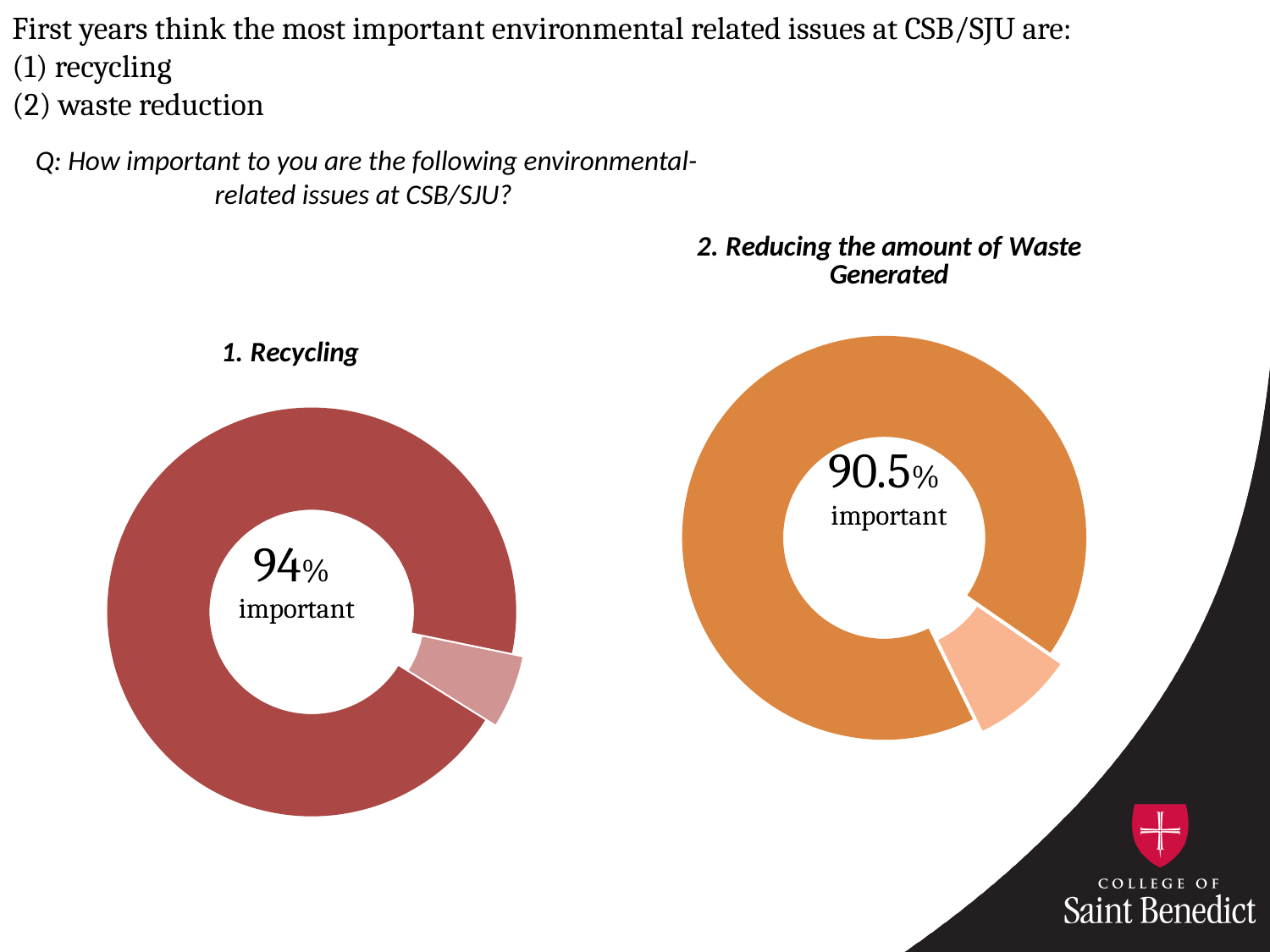
Is the 'important' value in the '2. Reducing the amount of Waste Generated' chart greater or less than 95%? less In the '2. Reducing the amount of Waste Generated' chart, what percentage of first years rate waste reduction as important? 90.5% What is the difference between the 'important' percentage in the '1. Recycling' chart and the one in the '2. Reducing the amount of Waste Generated' chart? 3.5% What kind of chart is the '2. Reducing the amount of Waste Generated' chart? doughnut chart How many slices does the '1. Recycling' chart have? 2 What is the title of the chart on the left of the slide? 1. Recycling Which chart shows the larger 'important' share: '1. Recycling' or '2. Reducing the amount of Waste Generated'? 1. Recycling How many charts are shown on the slide? 2 How many slices does the '2. Reducing the amount of Waste Generated' chart have? 2 What is the title of the chart on the right of the slide? 2. Reducing the amount of Waste Generated What kind of chart is the '1. Recycling' chart? doughnut chart In the '1. Recycling' chart, what percentage of first years rate recycling as important? 94%